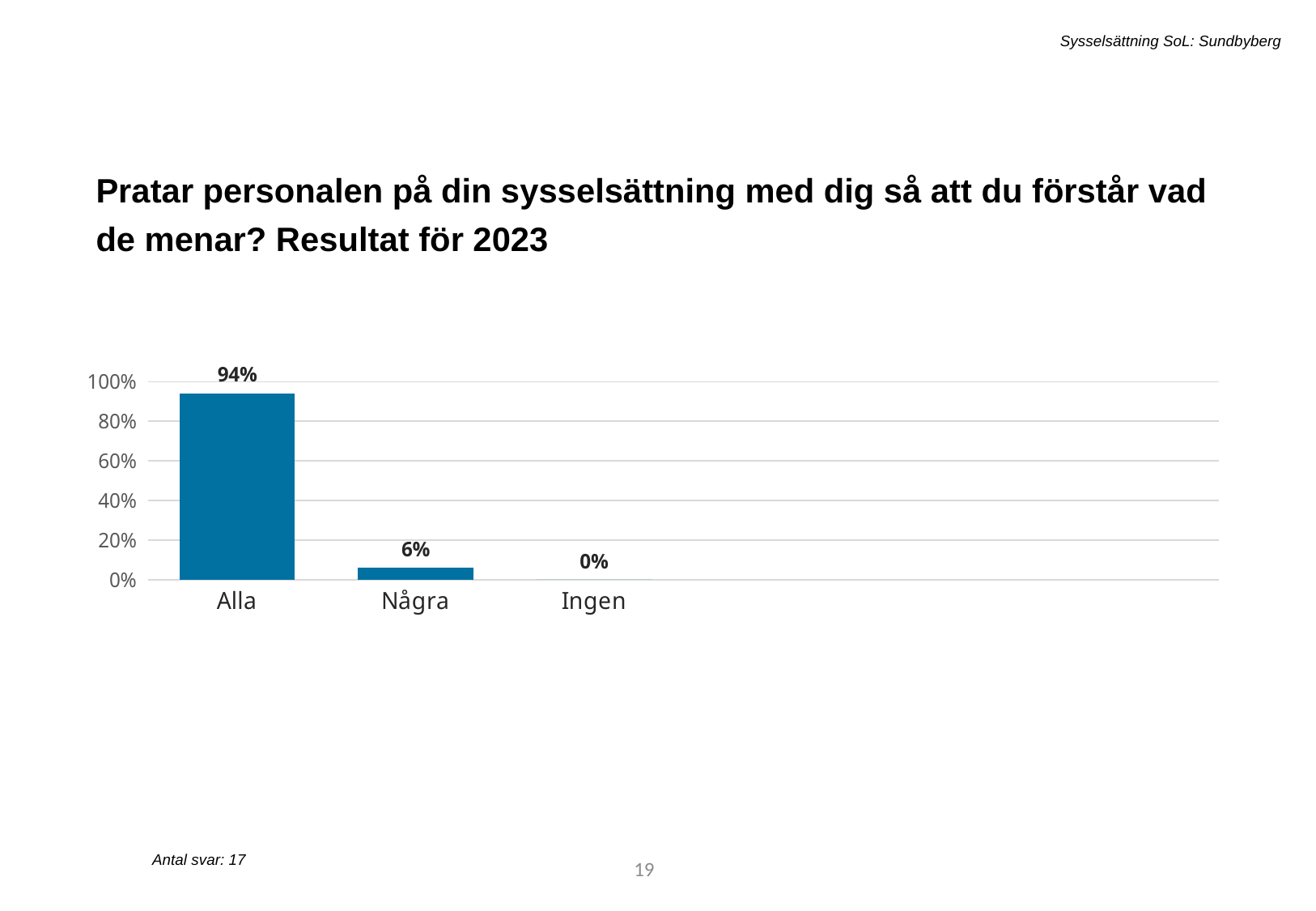
What is the value for Ingen? 0% What is the value for Alla? 94% How many responses (Antal svar) does the slide report? 17 Which category has the highest value? Alla How many categories are shown on the x axis? 3 Which is larger, the value for Några or the value for Ingen? Några Do the values rise or fall from left to right along the x axis? fall Which category has the lowest value? Ingen Is the value for Alla greater or less than 80%? greater What is the value for Några? 6% What kind of chart is shown on the slide? bar chart What is the difference between the values for Alla and Några? 88%